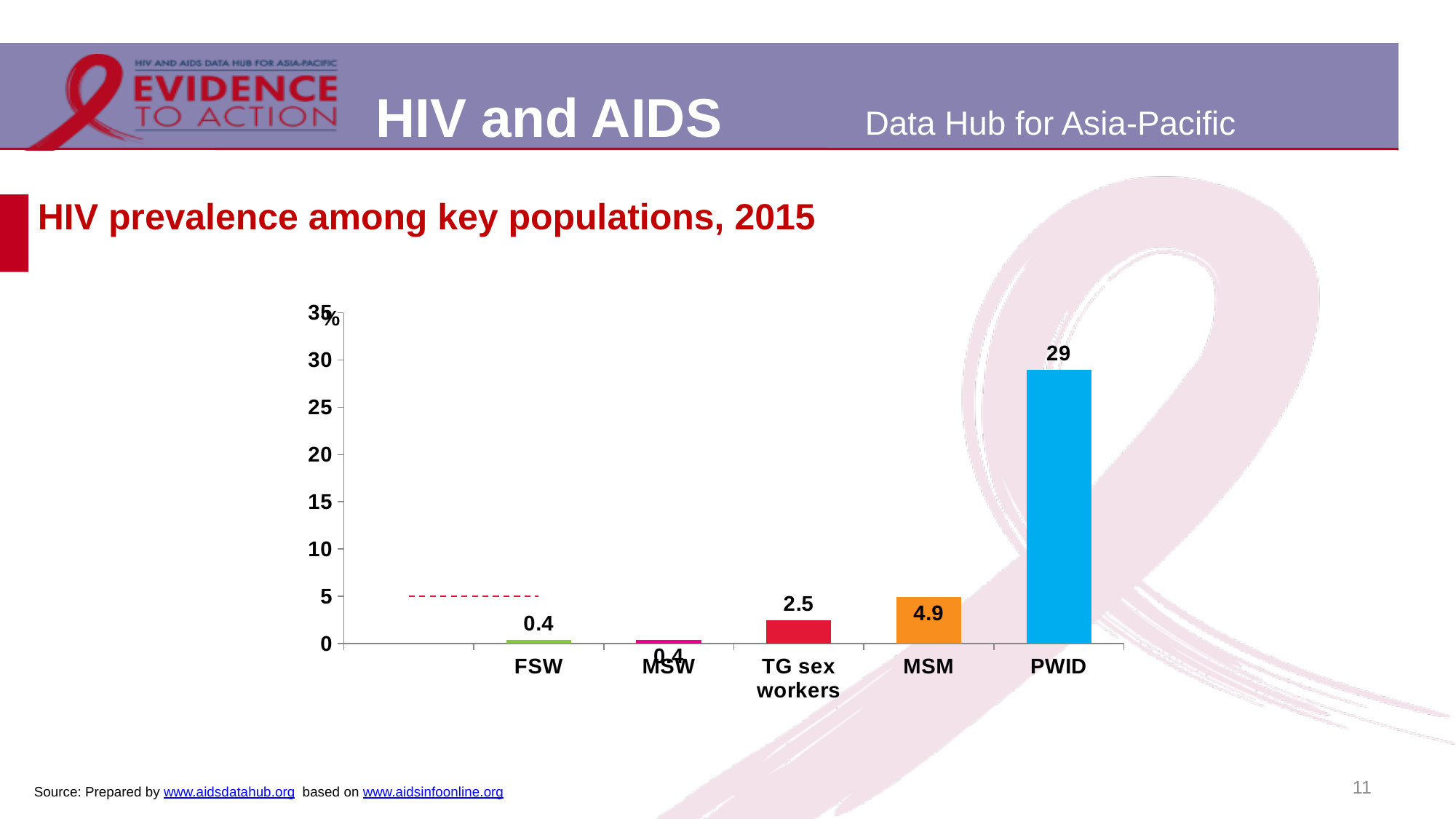
What is the HIV prevalence value shown for FSW? 0.4 Which is larger, the value for MSM or the value for TG sex workers? MSM What kind of chart is shown on the slide? bar chart What is the difference between the values for PWID and MSM? 24.1 How many key population categories are shown on the chart? 5 Is the value for PWID greater or less than 25? greater What is the HIV prevalence value shown for PWID? 29 What is the HIV prevalence value shown for MSM? 4.9 What is the title of the chart on the slide? HIV prevalence among key populations, 2015 What is the HIV prevalence value shown for TG sex workers? 2.5 What is the difference between the values for MSM and TG sex workers? 2.4 Which key population has the highest HIV prevalence? PWID